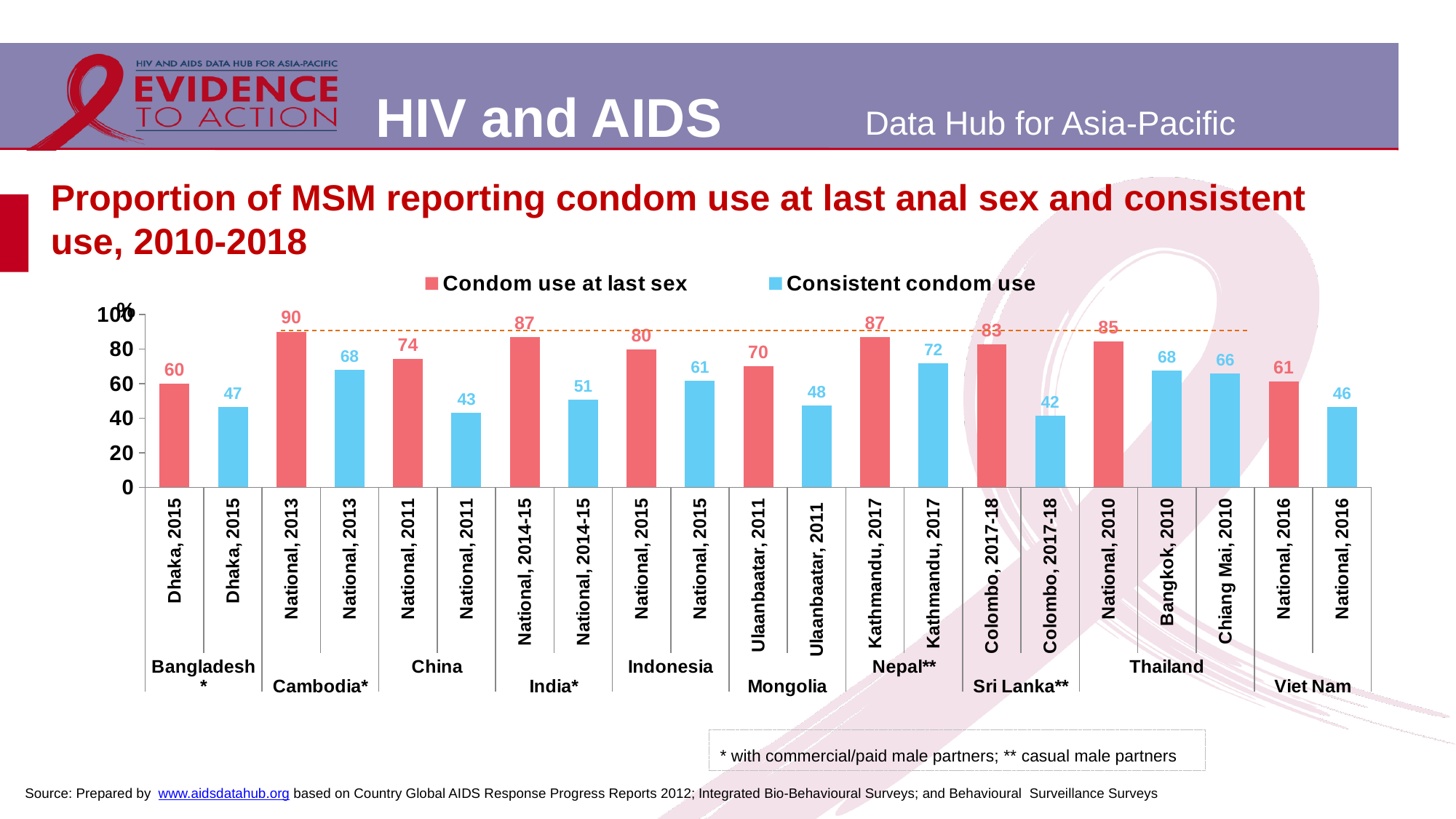
Which location has the lowest consistent condom use value? Colombo, 2017-18 (Sri Lanka) What is the consistent condom use value for Kathmandu, 2017 (Nepal)? 72 What kind of chart is shown on the slide? bar chart What is the difference between condom use at last sex and consistent condom use for China (National, 2011)? 31 How many series does the legend list? 2 Which country has the highest value for condom use at last sex? Cambodia Is the consistent condom use value for Colombo, 2017-18 greater or less than 60? less How many countries are shown on the x axis of the chart? 10 What is the difference between condom use at last sex and consistent condom use for Kathmandu, 2017? 15 What is the value for condom use at last sex in Cambodia (National, 2013)? 90 What is the consistent condom use value for Bangkok, 2010 (Thailand)? 68 Which has a higher consistent condom use value: Indonesia (National, 2015) or Mongolia (Ulaanbaatar, 2011)? Indonesia